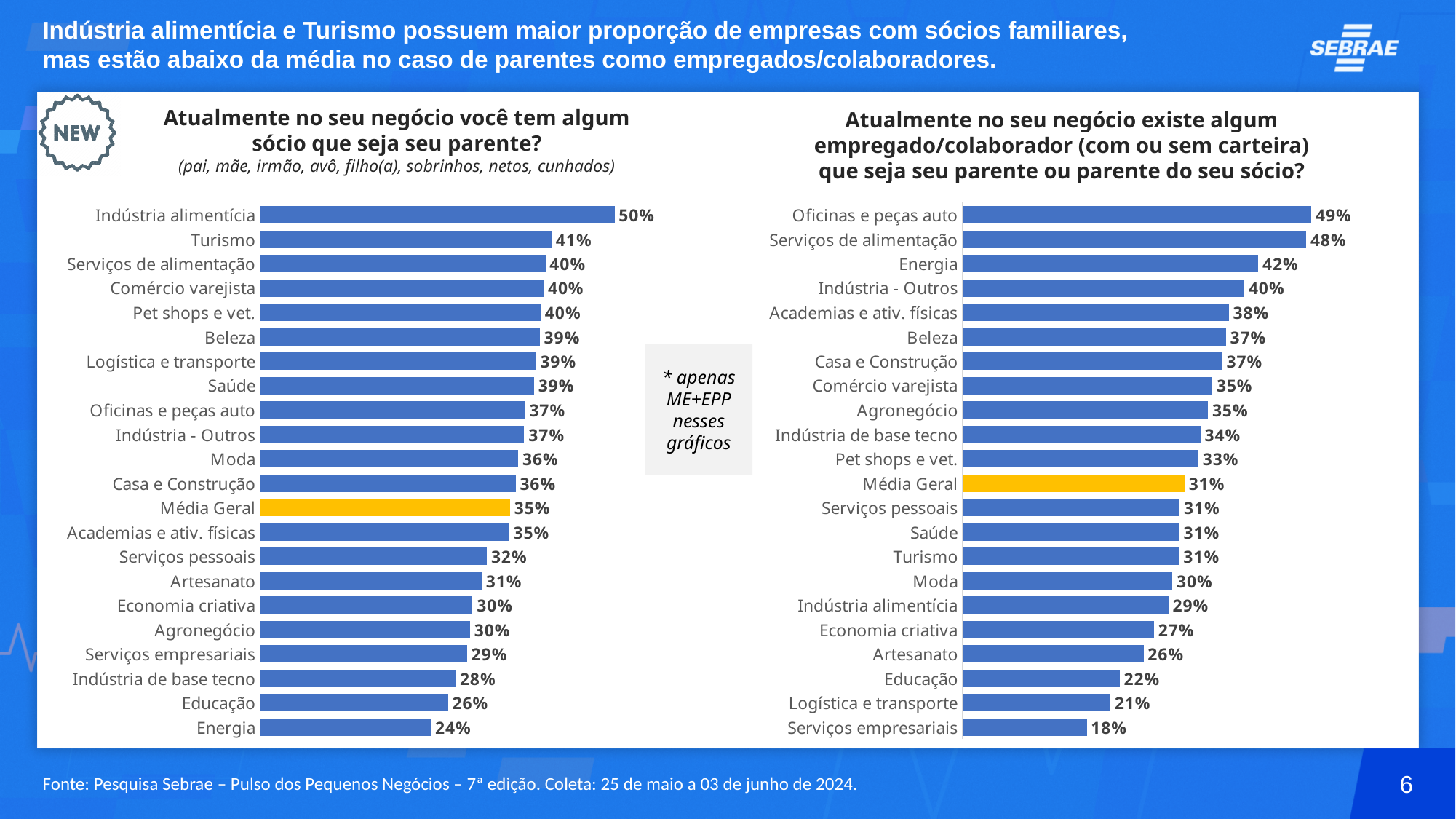
What type of chart is used on this slide? Bar chart In the right chart (empregado/colaborador que seja seu parente), what is the value for Energia? 42% How many categories (bars) are shown in the left chart (sócio que seja seu parente)? 22 In the right chart (empregado/colaborador que seja seu parente), what is the value of Média Geral? 31% In the right chart (empregado/colaborador que seja seu parente), which category has the lowest value? Serviços empresariais In the right chart (empregado/colaborador que seja seu parente), which is larger: Beleza or Moda? Beleza In the right chart (empregado/colaborador que seja seu parente), what is the difference between Oficinas e peças auto and Serviços empresariais? 31 percentage points In the left chart (sócio que seja seu parente), what is the difference between Indústria alimentícia and Média Geral? 15 percentage points In the left chart (sócio que seja seu parente), which category has the highest value? Indústria alimentícia Which bar is highlighted in yellow in both charts? Média Geral In the left chart (sócio que seja seu parente), which is larger: Energia or Educação? Educação In the left chart (sócio que seja seu parente), what is the value for Turismo? 41%